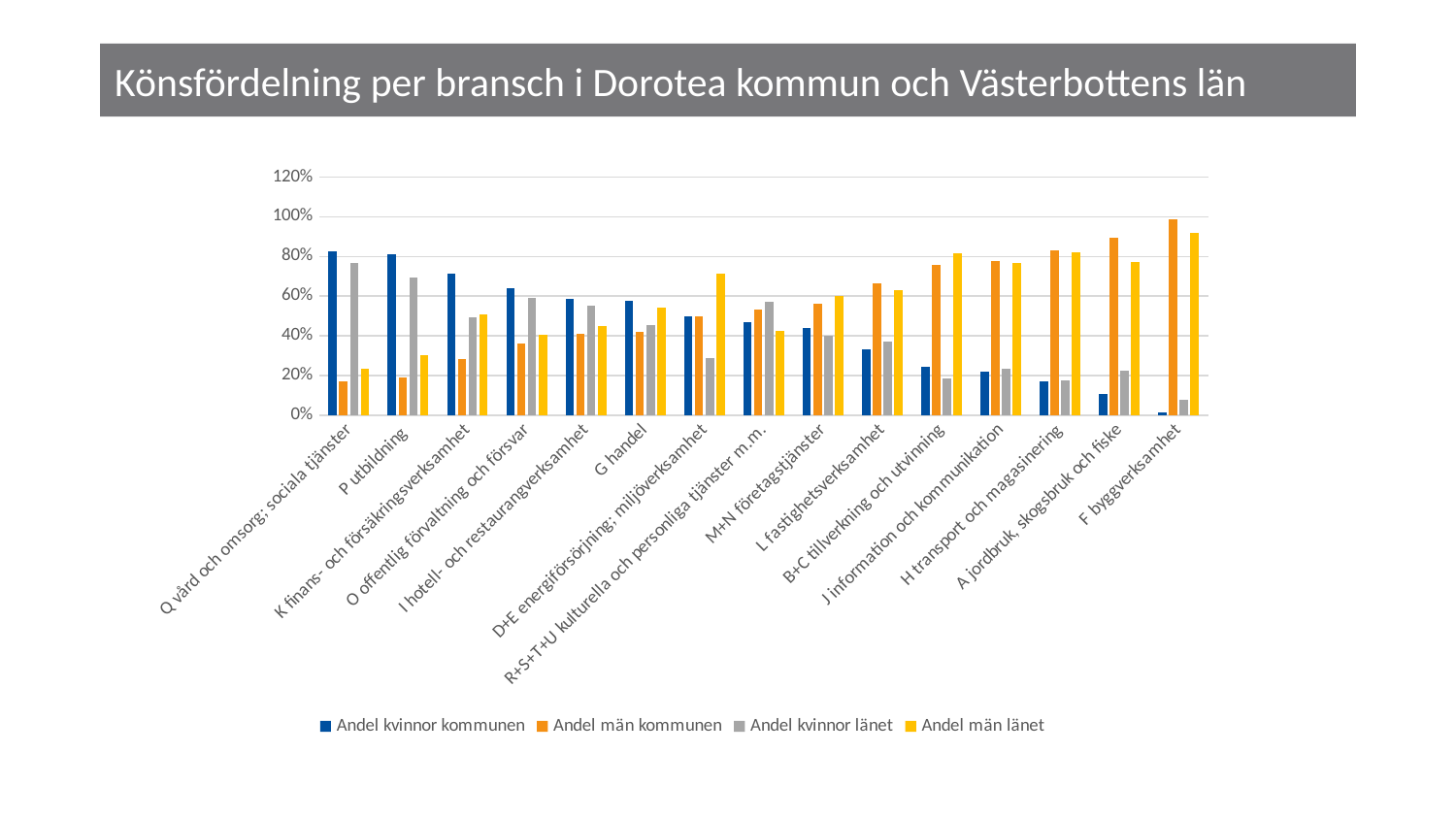
Is the value for Andel män kommunen in F byggverksamhet greater or less than 80%? greater Do the values for Andel kvinnor kommunen generally rise or fall from left to right along the x axis? Fall In Q vård och omsorg; sociala tjänster, which is larger: Andel kvinnor kommunen or Andel kvinnor länet? Andel kvinnor kommunen What is the title of the chart? Könsfördelning per bransch i Dorotea kommun och Västerbottens län How many industry categories are shown on the x axis? 15 Which category has the highest value for Andel män länet? F byggverksamhet Which category has the lowest value for Andel kvinnor kommunen? F byggverksamhet Which category has the highest value for Andel män kommunen? F byggverksamhet Is the value for Andel män länet in D+E energiförsörjning; miljöverksamhet greater or less than 60%? greater What kind of chart is shown on the slide? Bar chart How many series does the legend list? 4 Is the value for Andel kvinnor kommunen in A jordbruk, skogsbruk och fiske greater or less than 20%? less